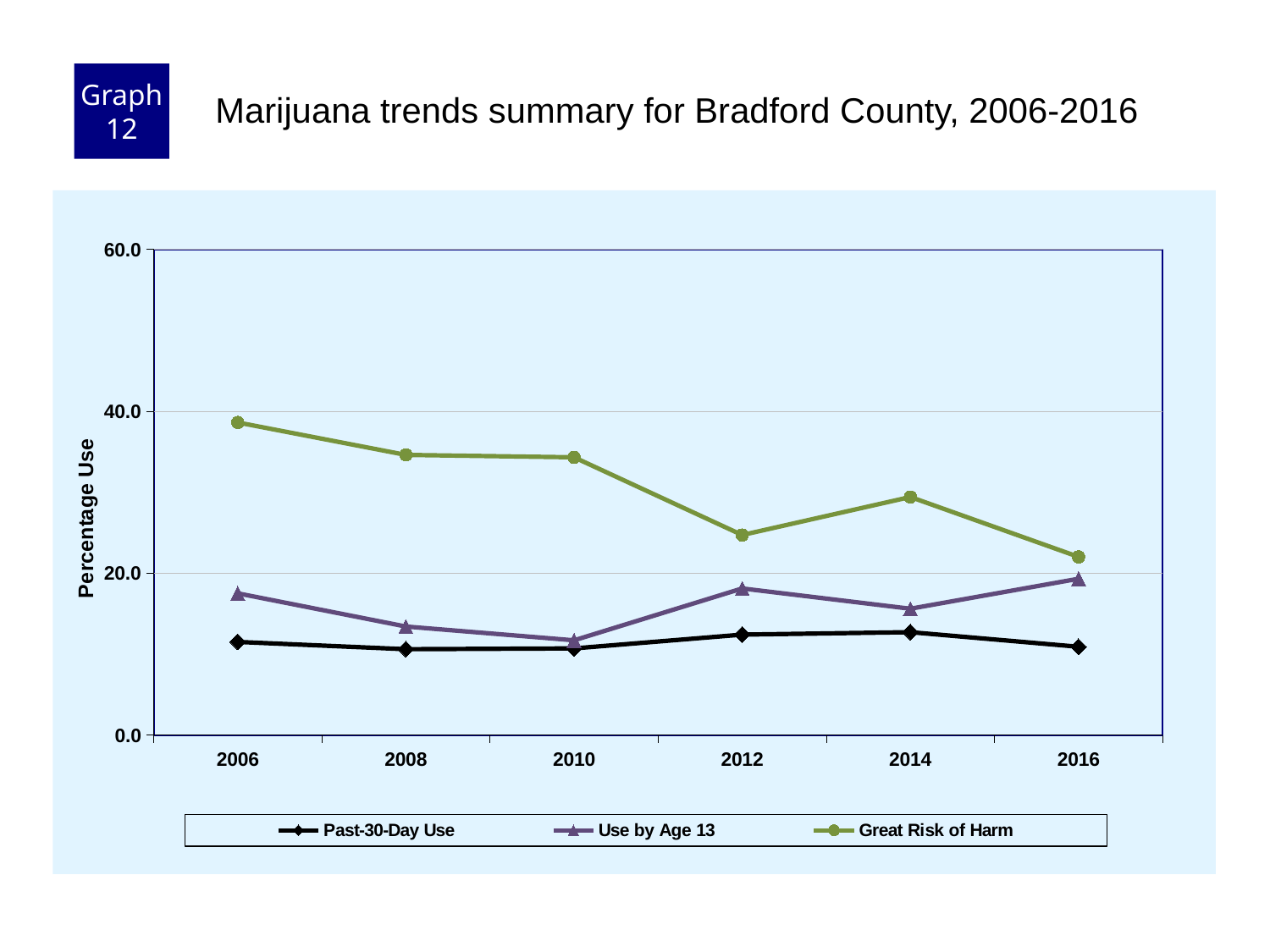
What is the label on the y axis? Percentage Use What kind of chart is shown on the slide? line chart In which year is the Great Risk of Harm series at its lowest? 2016 Is the value for Great Risk of Harm in 2006 greater or less than 20.0? greater Is the value for Great Risk of Harm in 2012 greater or less than 40.0? less Which series has the highest value in 2014? Great Risk of Harm How many series does the legend list? 3 Does the Great Risk of Harm series generally rise or fall from 2006 to 2016? fall In 2006, which is larger: Great Risk of Harm or Past-30-Day Use? Great Risk of Harm Is the value for Use by Age 13 in 2010 greater or less than 20.0? less In which year is the Great Risk of Harm series at its highest? 2006 How many years are plotted along the x axis? 6